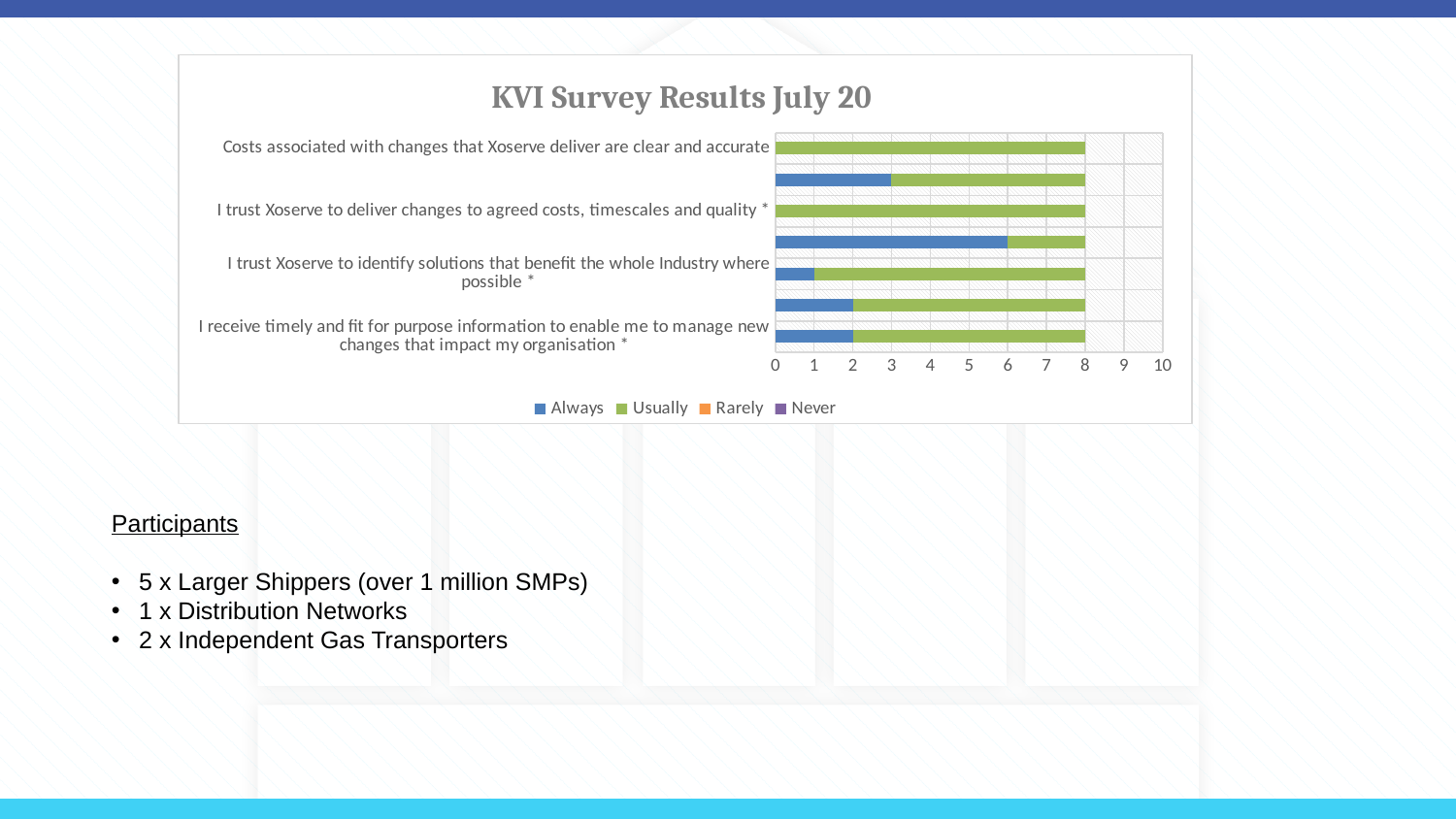
Which series is shown in blue in the legend? Always How many bars are plotted in the chart? 7 What is the total of the stacked bar for 'I trust Xoserve to deliver changes to agreed costs, timescales and quality *'? 8 What is the difference between the 'Always' values for 'I receive timely and fit for purpose information to enable me to manage new changes that impact my organisation *' and 'I trust Xoserve to identify solutions that benefit the whole Industry where possible *'? 1 What kind of chart is shown on the slide? Stacked bar chart What is the 'Usually' value for 'Costs associated with changes that Xoserve deliver are clear and accurate'? 8 What is the title of the chart? KVI Survey Results July 20 What is the 'Always' value for 'I receive timely and fit for purpose information to enable me to manage new changes that impact my organisation *'? 2 How many series does the chart legend list? 4 What is the 'Always' value for 'I trust Xoserve to identify solutions that benefit the whole Industry where possible *'? 1 Is the total of the stacked bar for 'Costs associated with changes that Xoserve deliver are clear and accurate' greater or less than 5? greater Which has the larger 'Always' value: 'I receive timely and fit for purpose information to enable me to manage new changes that impact my organisation *' or 'I trust Xoserve to identify solutions that benefit the whole Industry where possible *'? I receive timely and fit for purpose information to enable me to manage new changes that impact my organisation *